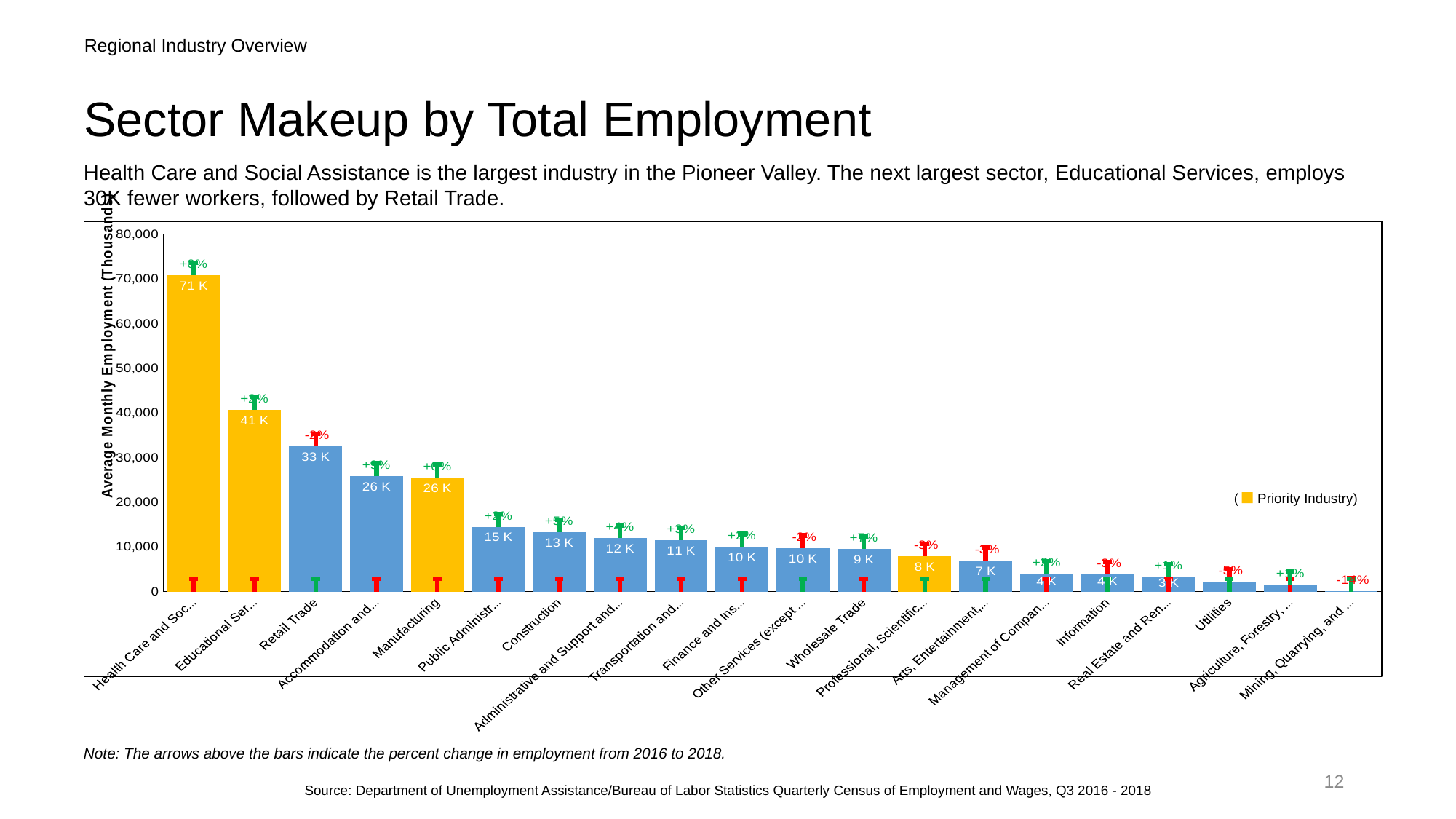
What is the value labelled on the Manufacturing bar? 26 K What is the difference between the labelled values for Health Care and Social Assistance (71 K) and Educational Services (41 K)? 30 K Which has a larger value, Retail Trade or Construction? Retail Trade What kind of chart is shown on the slide? Bar chart How many sectors are shown on the x axis? 20 What is the average monthly employment value shown for Retail Trade? 33 K What is the value labelled on the Construction bar? 13 K What is the value labelled on the Wholesale Trade bar? 9 K Do the bar values rise or fall from left to right along the x axis? Fall Which sector has the lowest average monthly employment? Mining, Quarrying, and ... Is the value for Utilities greater or less than 10,000? less Which sector has the highest average monthly employment? Health Care and Social Assistance